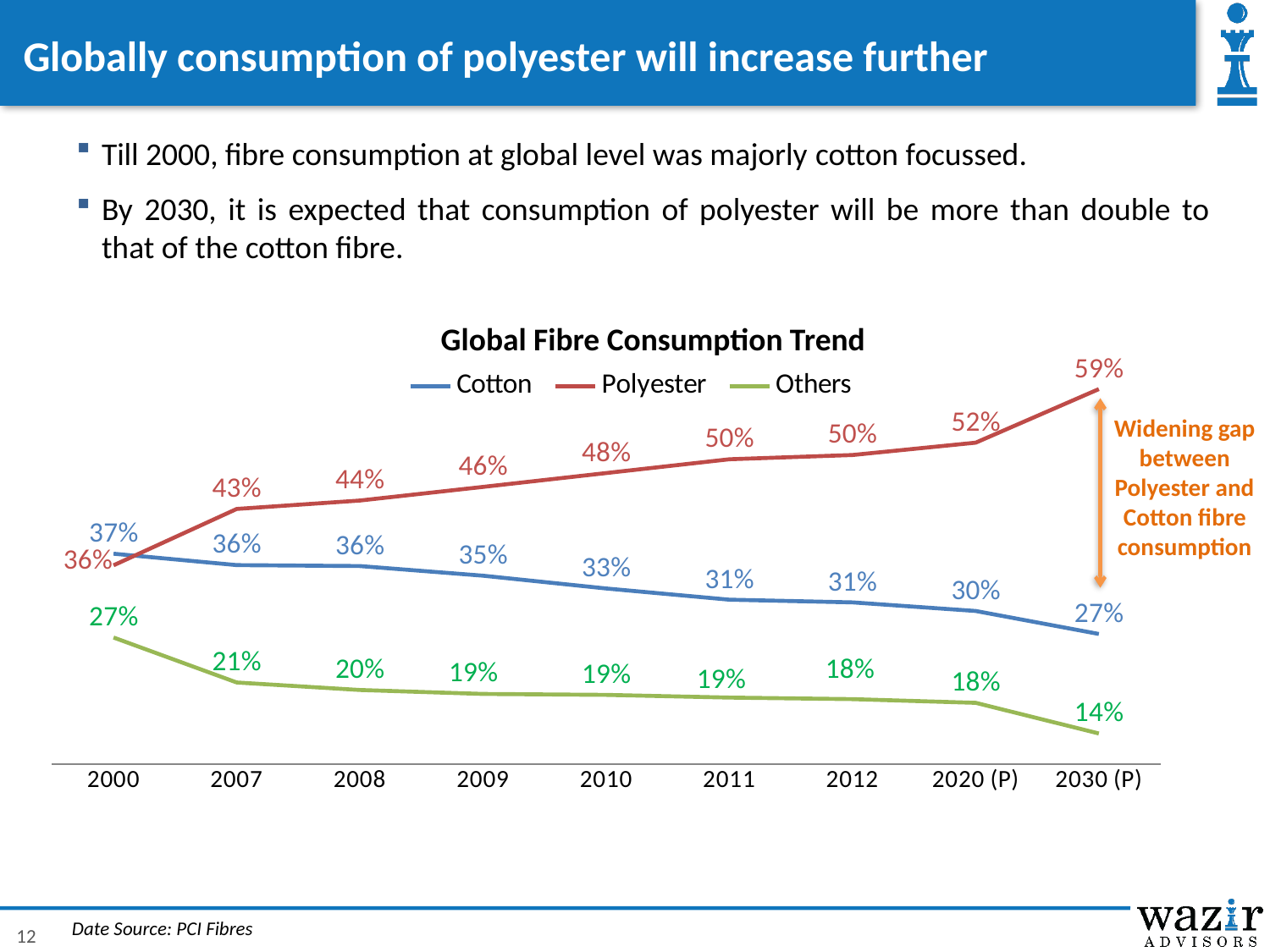
What is the difference between the Polyester and Cotton values in 2030 (P)? 32% What is the Others value for 2009? 19% How many series does the legend list? 3 What kind of chart is shown? Line chart Does the Others series rise or fall from 2000 to 2030 (P)? Fall What is the Cotton value for 2000? 37% What is the Polyester value for 2011? 50% In which year is the Polyester value highest? 2030 (P) Which is larger in 2000, the Cotton value or the Polyester value? Cotton In which year is the Cotton value lowest? 2030 (P) What is the Polyester value for 2030 (P)? 59% How many years are shown on the x axis? 9